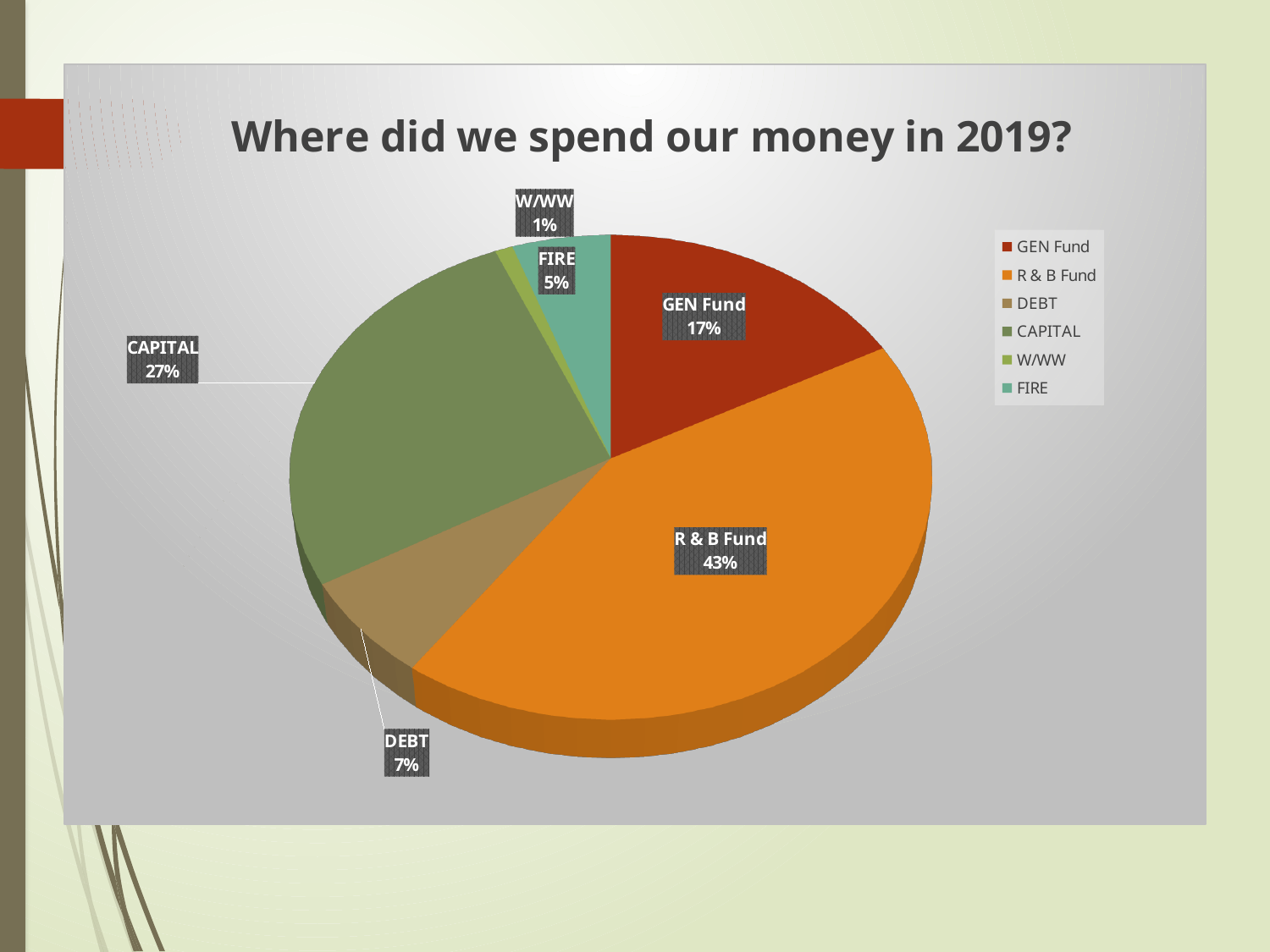
What type of chart is shown on the slide? Pie chart Which category has the largest slice of the pie? R & B Fund What share of spending went to the R & B Fund? 43% How many categories does the pie chart show? 6 What percentage of the pie is CAPITAL? 27% What is the value for W/WW? 1% Which category has the smallest slice of the pie? W/WW What is the difference in percentage points between R & B Fund and CAPITAL? 16 What share does FIRE have? 5% Which is larger, GEN Fund or DEBT? GEN Fund What is the value shown for GEN Fund? 17% What percentage is labelled for DEBT? 7%